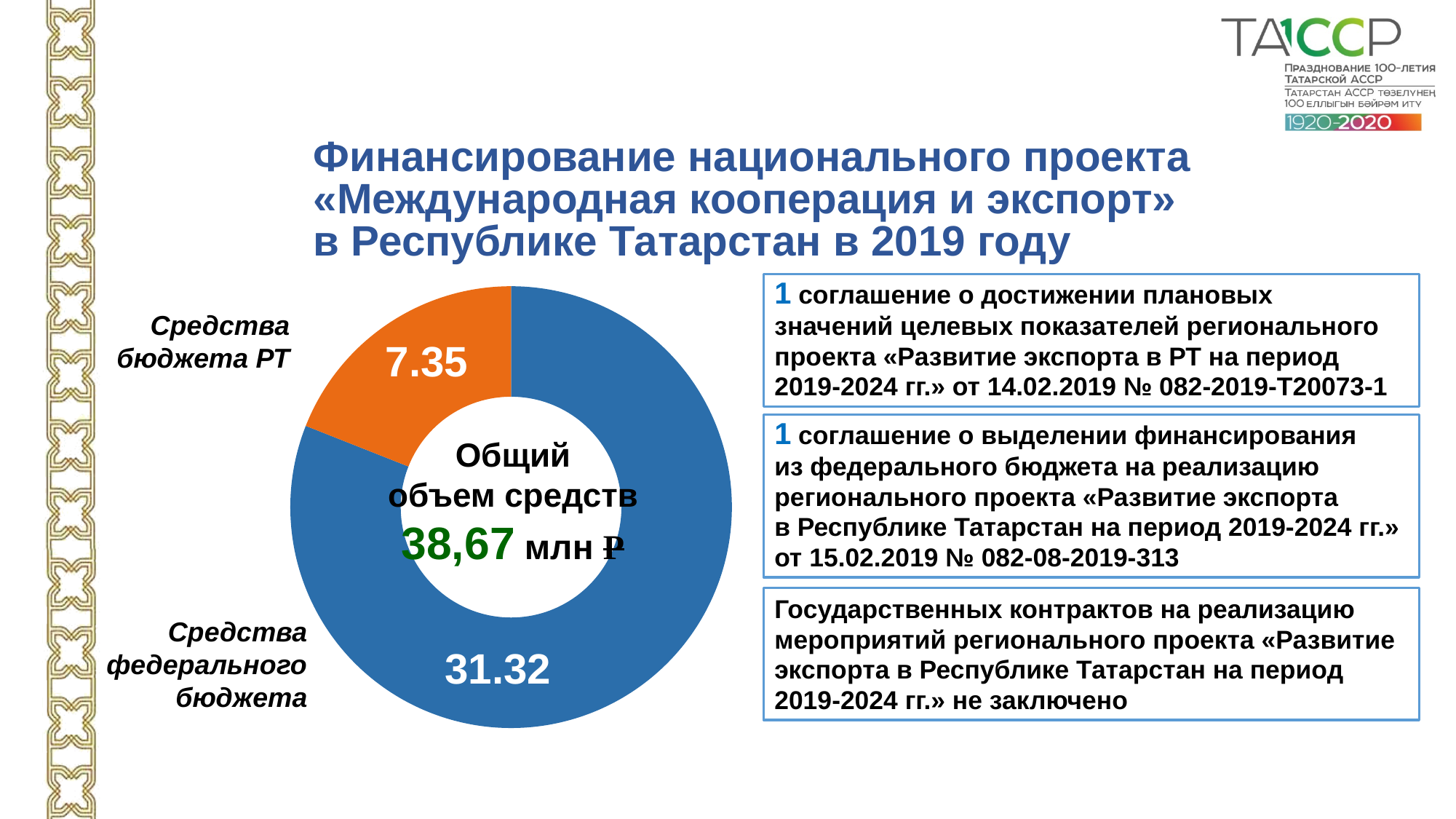
Which funding source has the smallest slice of the chart? Средства бюджета РТ Which funding source has the largest slice of the chart? Средства федерального бюджета What kind of chart is shown on the slide? Pie (donut) chart What total amount is shown in the centre of the chart? 38,67 млн ₽ How many slices does the chart have? 2 What colour is the slice for Средства бюджета РТ? Orange What is the difference between the value for Средства федерального бюджета and the value for Средства бюджета РТ? 23.97 Which is larger: Средства бюджета РТ or Средства федерального бюджета? Средства федерального бюджета What is the value for Средства федерального бюджета? 31.32 What is the value for Средства бюджета РТ? 7.35